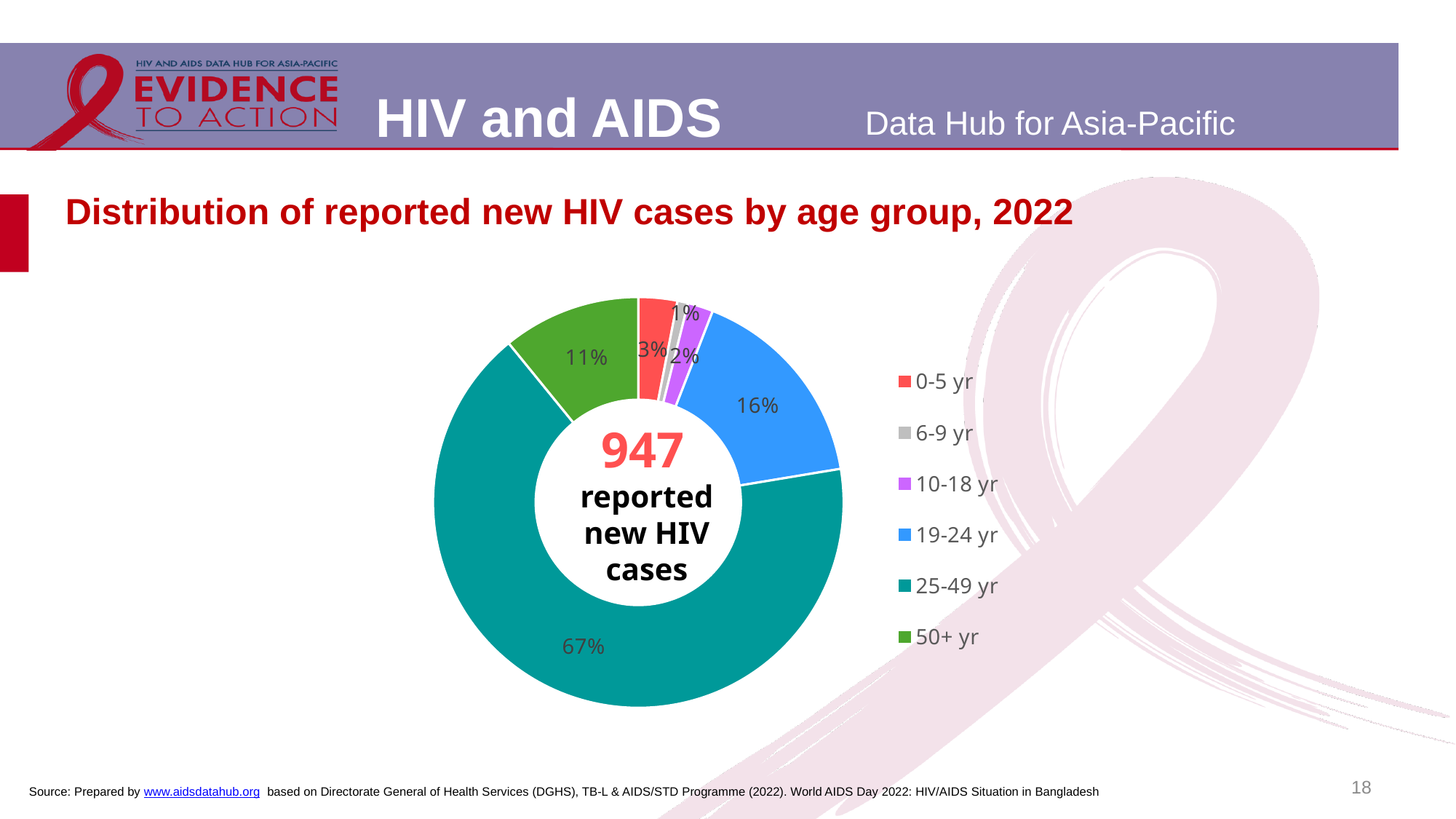
What kind of chart is used to show the distribution of new HIV cases by age group? Donut (pie) chart What share of reported new HIV cases is in the 25-49 yr age group? 67% Which age group has the smallest share of reported new HIV cases? 6-9 yr What share of reported new HIV cases is in the 0-5 yr age group? 3% What is the difference in percentage points between the 25-49 yr and 19-24 yr shares? 51 percentage points Which age group has a larger share of cases, 50+ yr or 19-24 yr? 19-24 yr What share of reported new HIV cases is in the 50+ yr age group? 11% What share of reported new HIV cases is in the 19-24 yr age group? 16% Which colour represents the 10-18 yr age group in the chart? Purple What is the total number of reported new HIV cases shown in the centre of the chart? 947 Which age group has the largest share of reported new HIV cases? 25-49 yr How many age groups are shown in the chart? 6